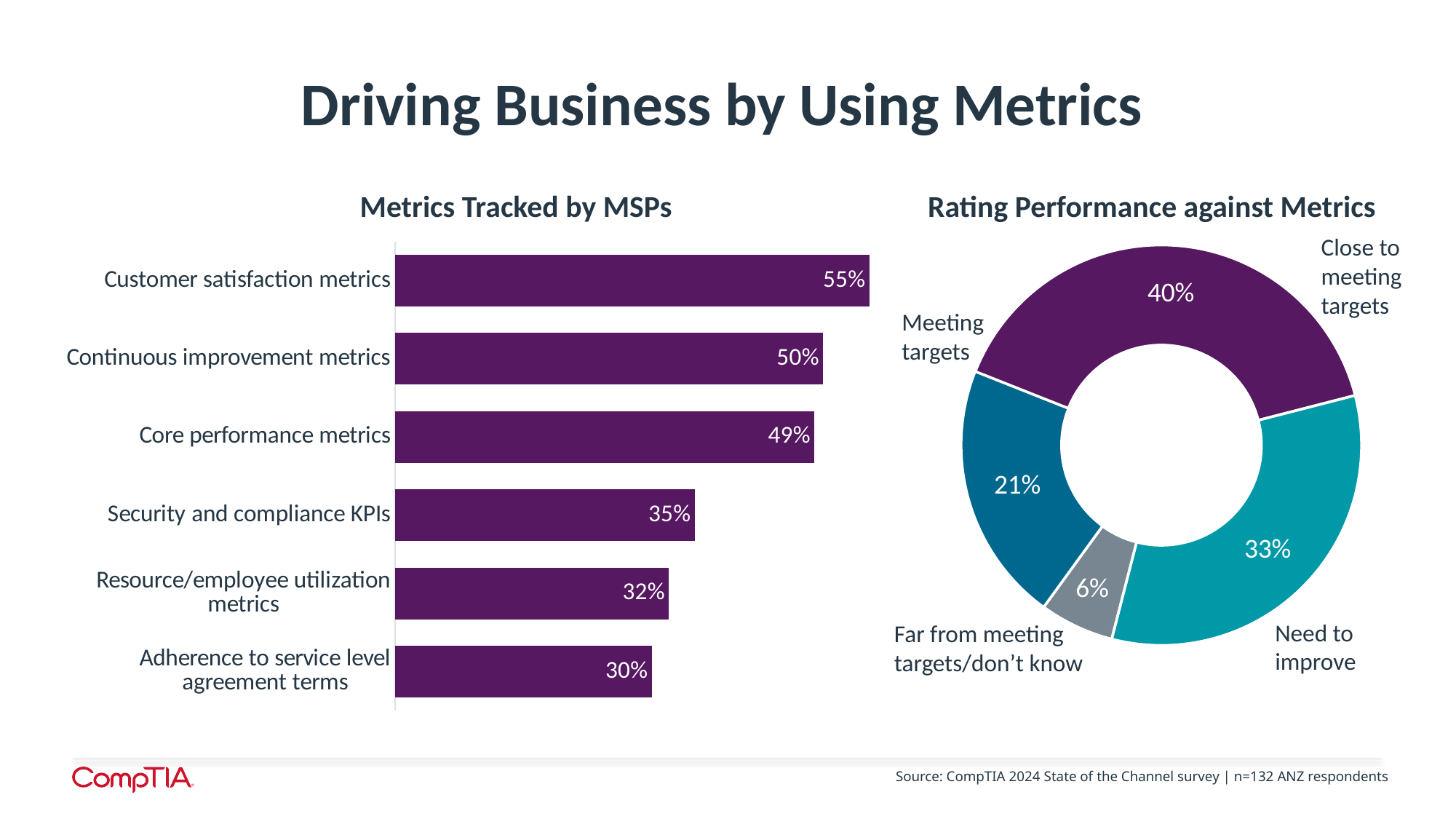
In the 'Metrics Tracked by MSPs' chart, how many metrics are listed? 6 In the 'Rating Performance against Metrics' chart, what share of respondents say they are meeting targets? 21% What type of chart is 'Rating Performance against Metrics'? Donut chart In the 'Rating Performance against Metrics' chart, which category has the largest share? Close to meeting targets In the 'Metrics Tracked by MSPs' chart, which metric has the lowest percentage? Adherence to service level agreement terms What type of chart is 'Metrics Tracked by MSPs'? Bar chart In the 'Metrics Tracked by MSPs' chart, which metric has the highest percentage? Customer satisfaction metrics In the 'Rating Performance against Metrics' chart, what share of respondents say they are far from meeting targets/don't know? 6% In the 'Metrics Tracked by MSPs' chart, what percentage of MSPs track customer satisfaction metrics? 55% In the 'Metrics Tracked by MSPs' chart, what is the value for Security and compliance KPIs? 35% In the 'Rating Performance against Metrics' chart, which is larger: Need to improve or Meeting targets? Need to improve In the 'Metrics Tracked by MSPs' chart, what is the difference between Continuous improvement metrics and Resource/employee utilization metrics? 18%